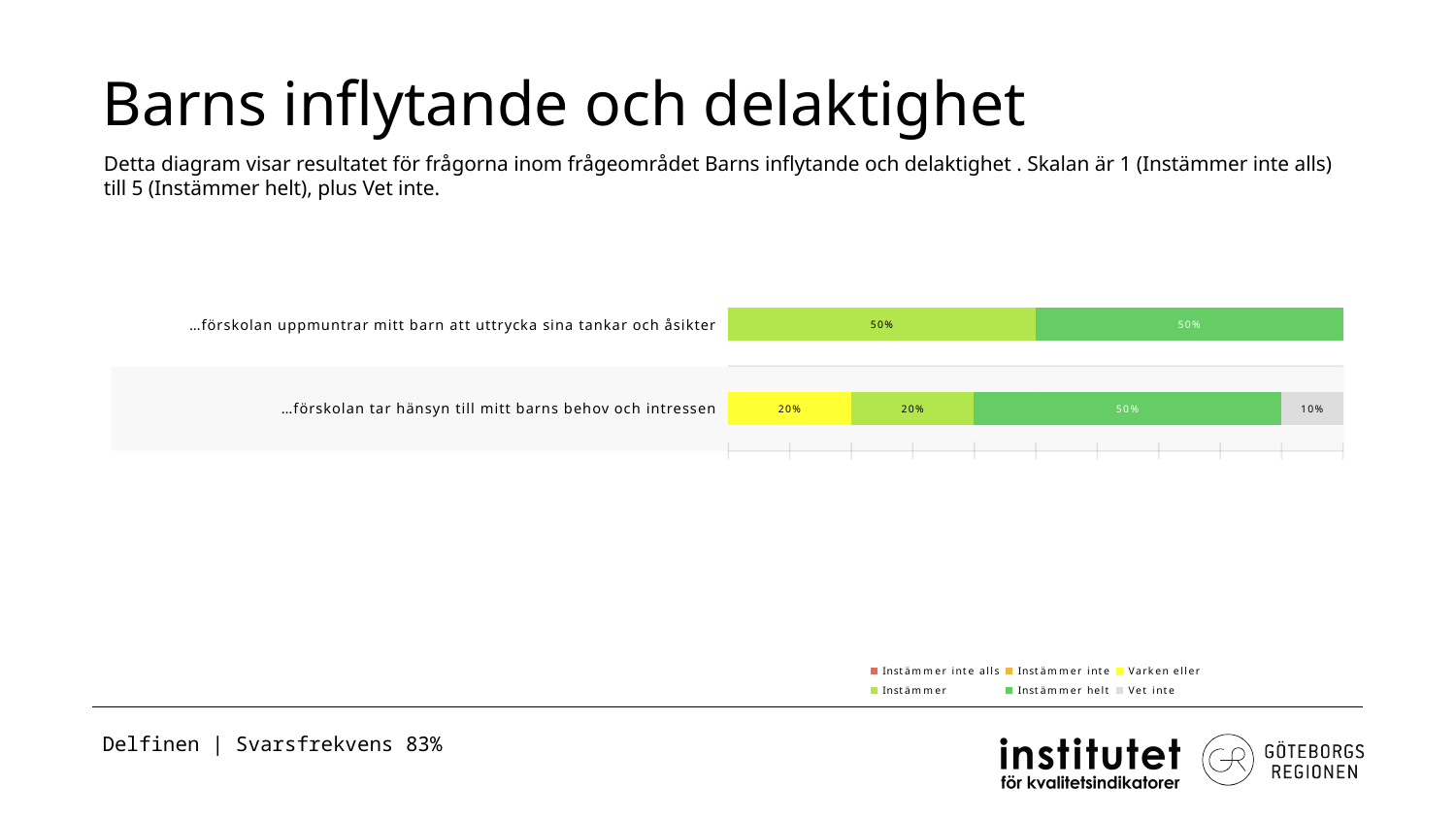
What is the value of the 'Vet inte' segment for '…förskolan tar hänsyn till mitt barns behov och intressen'? 10% For '…förskolan tar hänsyn till mitt barns behov och intressen', which is larger: the 'Instämmer' segment or the 'Instämmer helt' segment? Instämmer helt What is the value of the 'Instämmer helt' segment for '…förskolan uppmuntrar mitt barn att uttrycka sina tankar och åsikter'? 50% What is the total of the stacked bar for '…förskolan tar hänsyn till mitt barns behov och intressen'? 100% What is the value of the 'Instämmer helt' segment for '…förskolan tar hänsyn till mitt barns behov och intressen'? 50% What is the difference between the 'Instämmer helt' segment and the 'Vet inte' segment for '…förskolan tar hänsyn till mitt barns behov och intressen'? 40% How many series does the legend list? 6 What kind of chart is shown on the slide? bar chart How many categories (questions) are plotted in the chart? 2 Which legend entry is shown in grey? Vet inte What is the value of the 'Instämmer' segment for '…förskolan uppmuntrar mitt barn att uttrycka sina tankar och åsikter'? 50% What is the value of the 'Varken eller' segment for '…förskolan tar hänsyn till mitt barns behov och intressen'? 20%